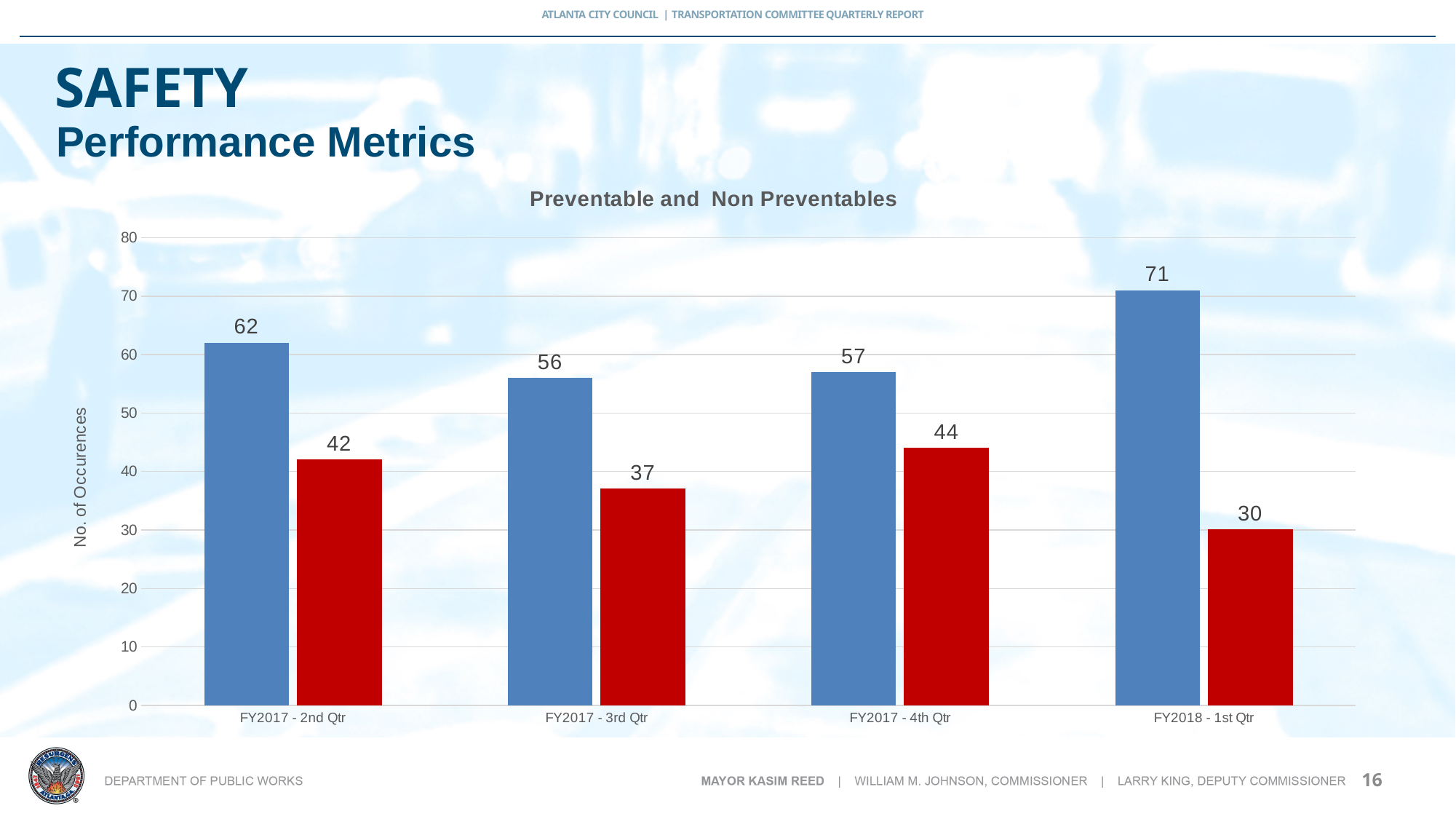
What is the value of the blue bar for FY2017 - 2nd Qtr? 62 Which quarter has the lowest red bar? FY2018 - 1st Qtr Which is larger, the red bar for FY2017 - 2nd Qtr or the red bar for FY2017 - 3rd Qtr? FY2017 - 2nd Qtr How many quarters are shown on the x axis? 4 Which quarter has the highest blue bar? FY2018 - 1st Qtr What kind of chart is shown on the slide? Bar chart What is the value of the red bar for FY2018 - 1st Qtr? 30 What is the difference between the blue bar values for FY2017 - 2nd Qtr and FY2017 - 3rd Qtr? 6 What is the label of the vertical axis? No. of Occurences What is the title of the chart? Preventable and Non Preventables What is the value of the red bar for FY2017 - 4th Qtr? 44 What is the difference between the blue and red bars for FY2018 - 1st Qtr? 41